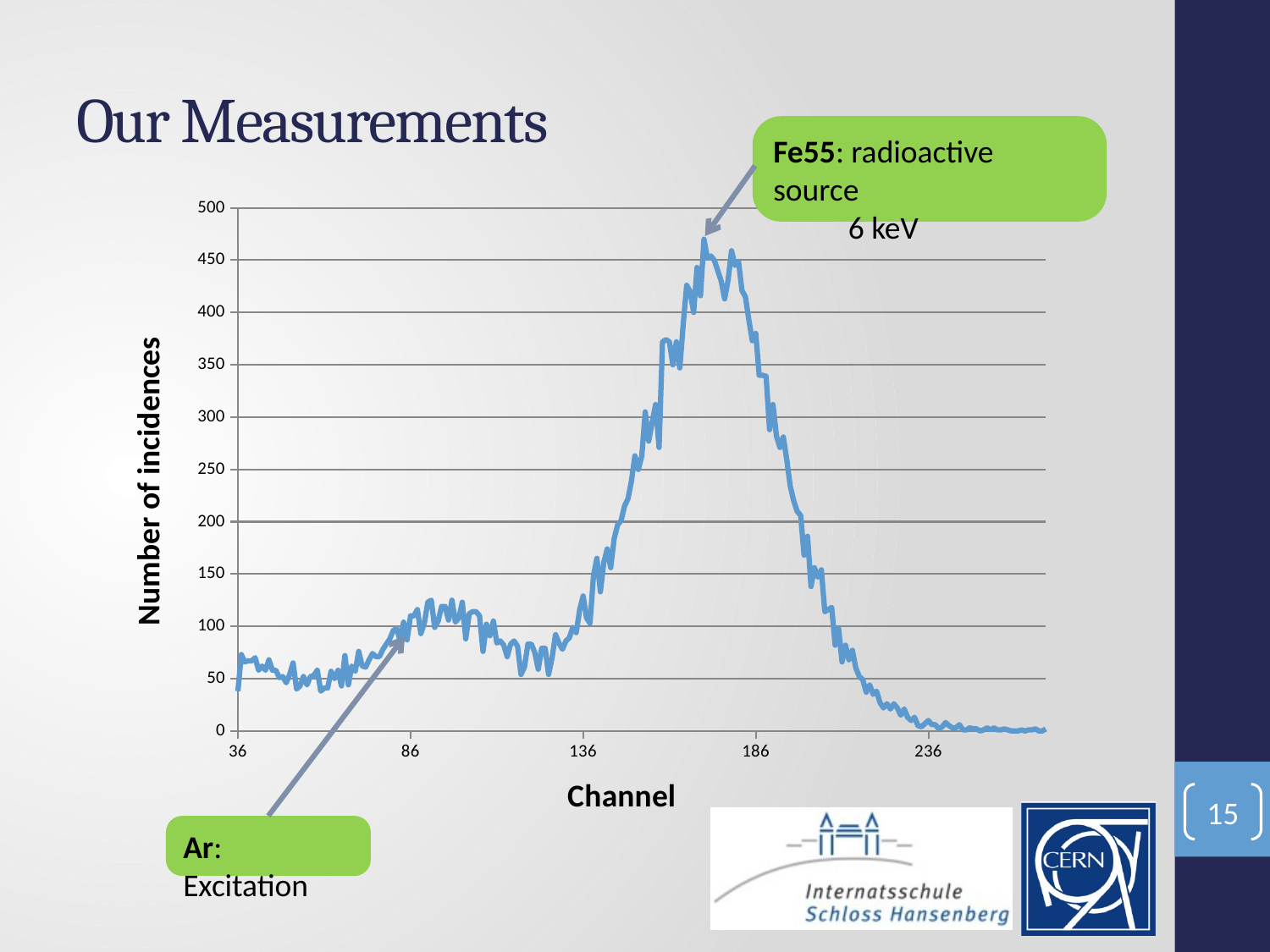
Which annotated peak is higher, the Fe55 peak or the Ar peak? Fe55 What is the maximum value shown on the y axis? 500 What kind of chart is shown on the slide? line chart What is the label of the x axis? Channel Is the value at channel 236 greater or less than 50? less What is the label of the y axis? Number of incidences How many labelled tick marks are on the x axis? 5 Is the value at channel 86 greater or less than 50? greater Is the value at channel 36 greater or less than 100? less Between channel 186 and channel 236, do the values rise or fall? fall